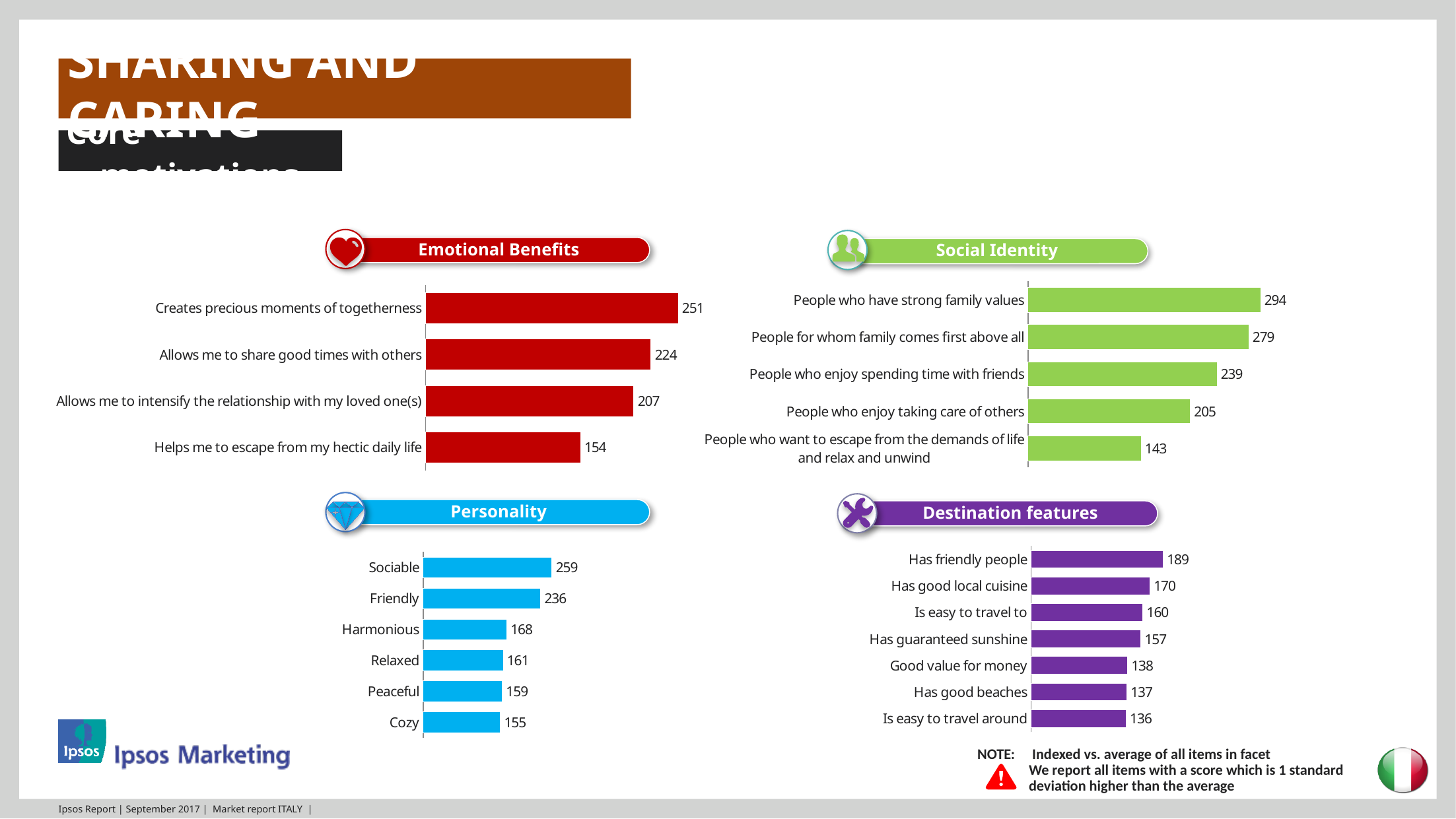
In the Personality chart, how many categories are shown? 6 What type of chart is the Emotional Benefits chart? Bar chart In the Destination features chart, what is the difference between "Has friendly people" and "Is easy to travel around"? 53 In the Emotional Benefits chart, what is the value for "Allows me to share good times with others"? 224 In the Destination features chart, how many categories are shown? 7 In the Social Identity chart, what is the difference between "People who have strong family values" and "People for whom family comes first above all"? 15 In the Personality chart, which is larger, Sociable or Friendly? Sociable In the Emotional Benefits chart, which category has the highest value? Creates precious moments of togetherness In the Destination features chart, what is the value for "Has guaranteed sunshine"? 157 In the Personality chart, what is the value for Harmonious? 168 In the Social Identity chart, which category has the lowest value? People who want to escape from the demands of life and relax and unwind In the Social Identity chart, what is the value for "People who enjoy taking care of others"? 205